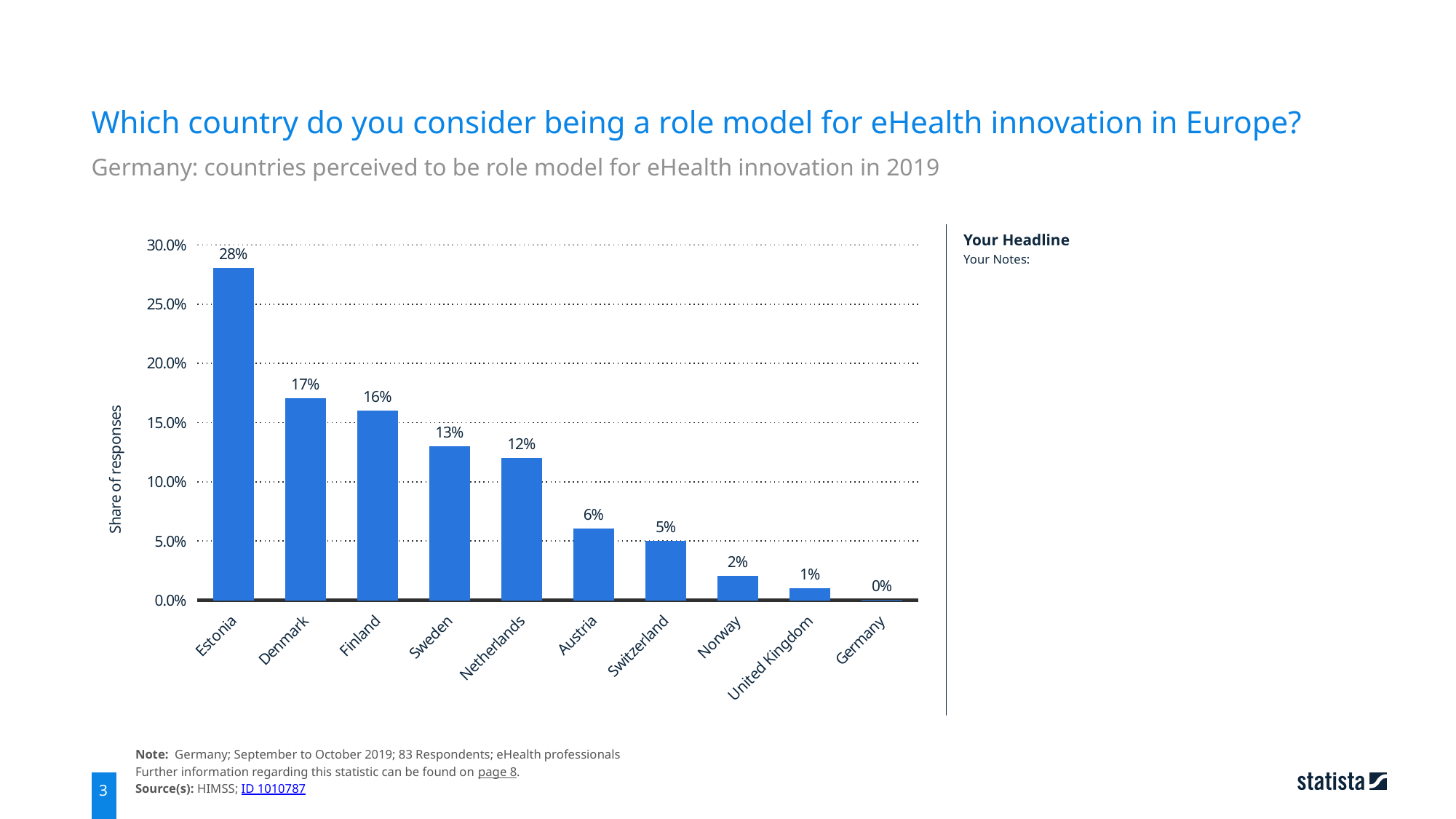
Is the value for Denmark greater or less than 15.0%? greater Which has a larger share of responses, Finland or Sweden? Finland How many countries are shown on the chart? 10 What is the label of the vertical axis? Share of responses What kind of chart is shown on the slide? Bar chart Which country has the highest share of responses? Estonia What share of responses is shown for Switzerland? 5% What is the difference between the shares for Netherlands and Austria? 6% Which country has the lowest share of responses? Germany What is the value shown for Sweden? 13% What is the difference between the shares for Estonia and Denmark? 11% What share of responses named Estonia as a role model for eHealth innovation? 28%